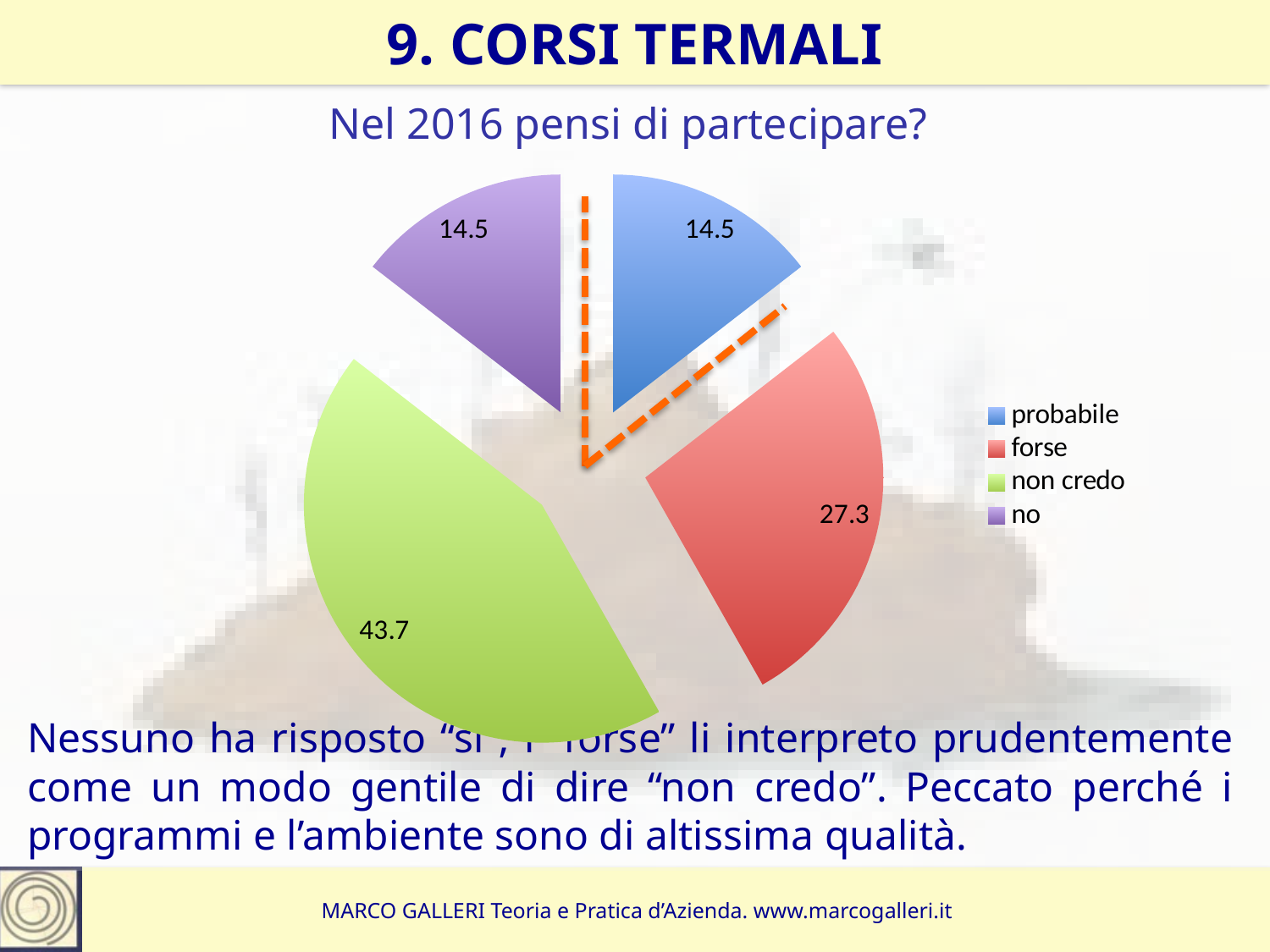
Which is larger, the value for "forse" or the value for "probabile"? forse What type of chart is shown on the slide? pie chart What is the value for "probabile"? 14.5 What is the difference between the values for "non credo" and "forse"? 16.4 What is the value for "forse"? 27.3 What colour is the "non credo" slice? green Which category has the largest slice of the pie? non credo How many categories does the legend list? 4 Which two categories share the smallest value in the pie? probabile and no What is the title of the chart? Nel 2016 pensi di partecipare? What is the value for "no"? 14.5 What is the value for "non credo"? 43.7